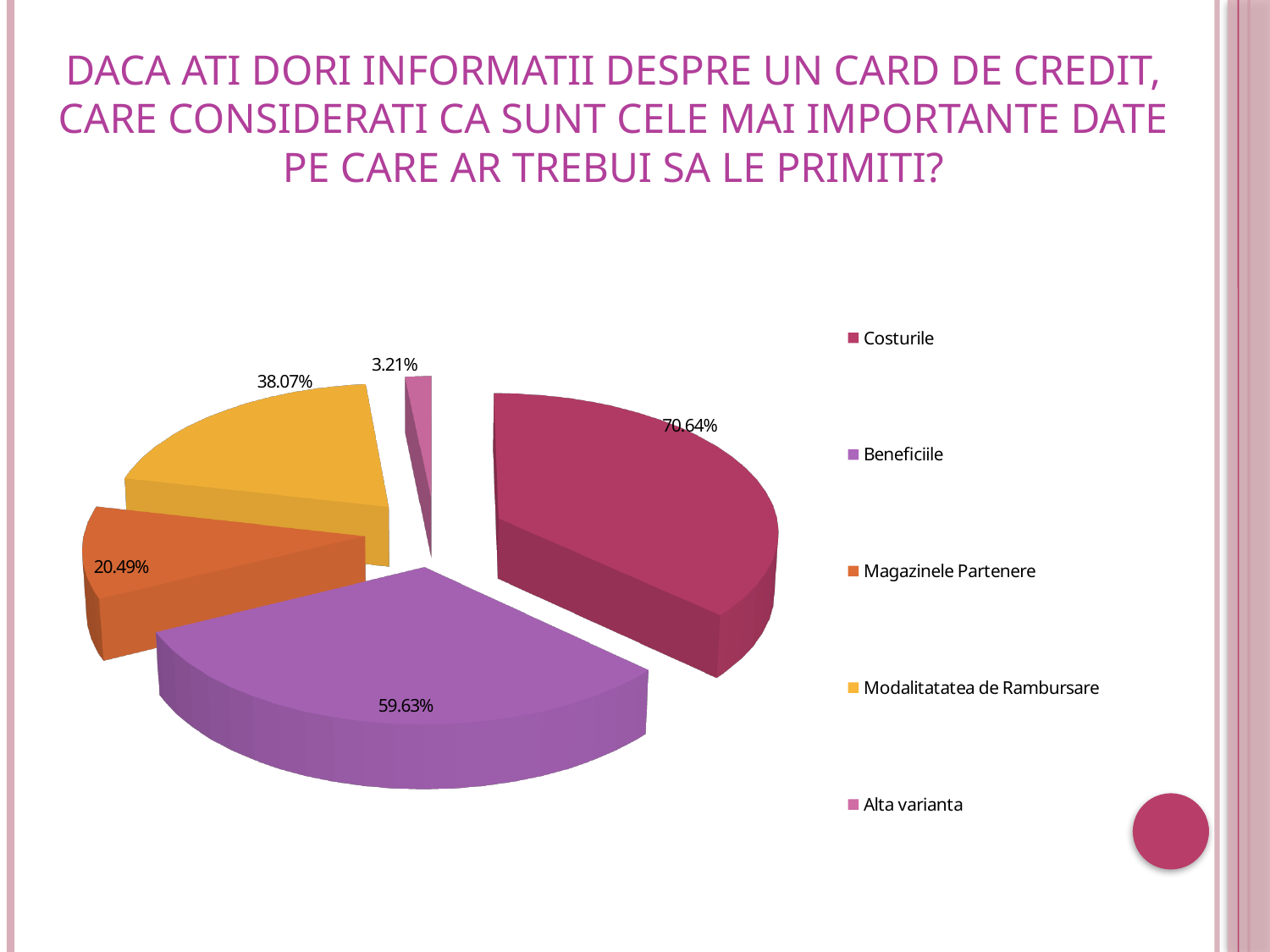
How many categories does the pie chart have? 5 What is the value shown for Magazinele Partenere? 20.49% Which is larger, the value for Modalitatatea de Rambursare or the value for Magazinele Partenere? Modalitatatea de Rambursare What is the value shown for Beneficiile? 59.63% What kind of chart is shown on the slide? pie chart What is the value shown for Alta varianta? 3.21% What is the difference between the values for Costurile and Beneficiile? 11.01% What is the value shown for Modalitatatea de Rambursare? 38.07% Which category has the highest value? Costurile Which category has the lowest value? Alta varianta What is the value shown for Costurile? 70.64% What colour is the slice for Beneficiile? purple